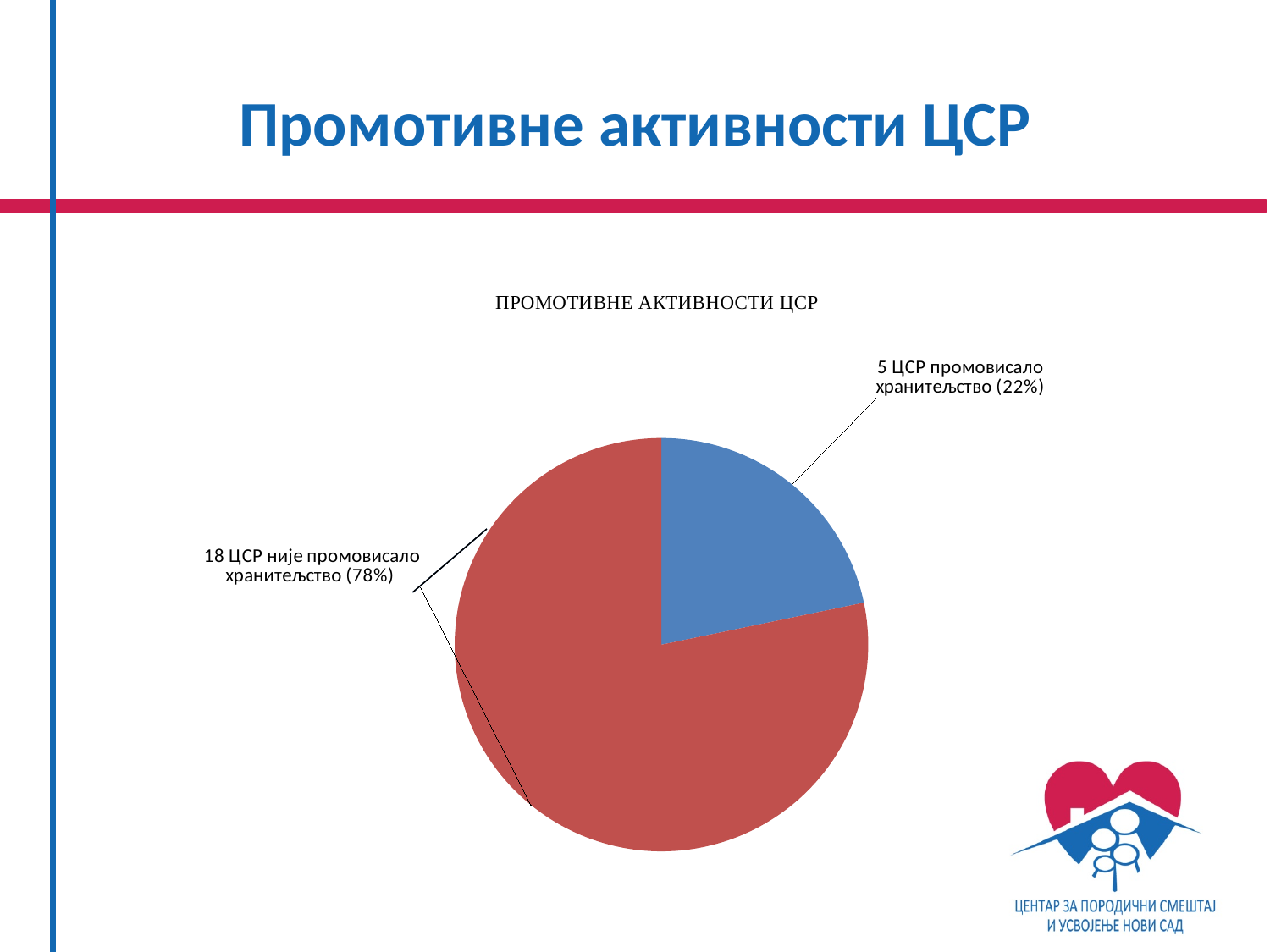
Which slice is the smallest in the pie chart? 5 ЦСР промовисало хранитељство (22%) What is the total number of ЦСР represented in the pie chart? 23 How many ЦСР promoted foster care (промовисало хранитељство) according to the chart? 5 What share of the pie is labelled "18 ЦСР није промовисало хранитељство"? 78% How many ЦСР did not promote foster care (није промовисало хранитељство) according to the chart? 18 How many slices does the pie chart have? 2 What is the title of the chart? ПРОМОТИВНЕ АКТИВНОСТИ ЦСР What colour is the slice for the 5 ЦСР that promoted foster care? blue Which slice is the largest in the pie chart? 18 ЦСР није промовисало хранитељство (78%) What share of the pie is labelled "5 ЦСР промовисало хранитељство"? 22% What kind of chart is shown on the slide? pie chart What is the difference in percentage points between the slice for ЦСР that did not promote foster care and the slice for ЦСР that did? 56